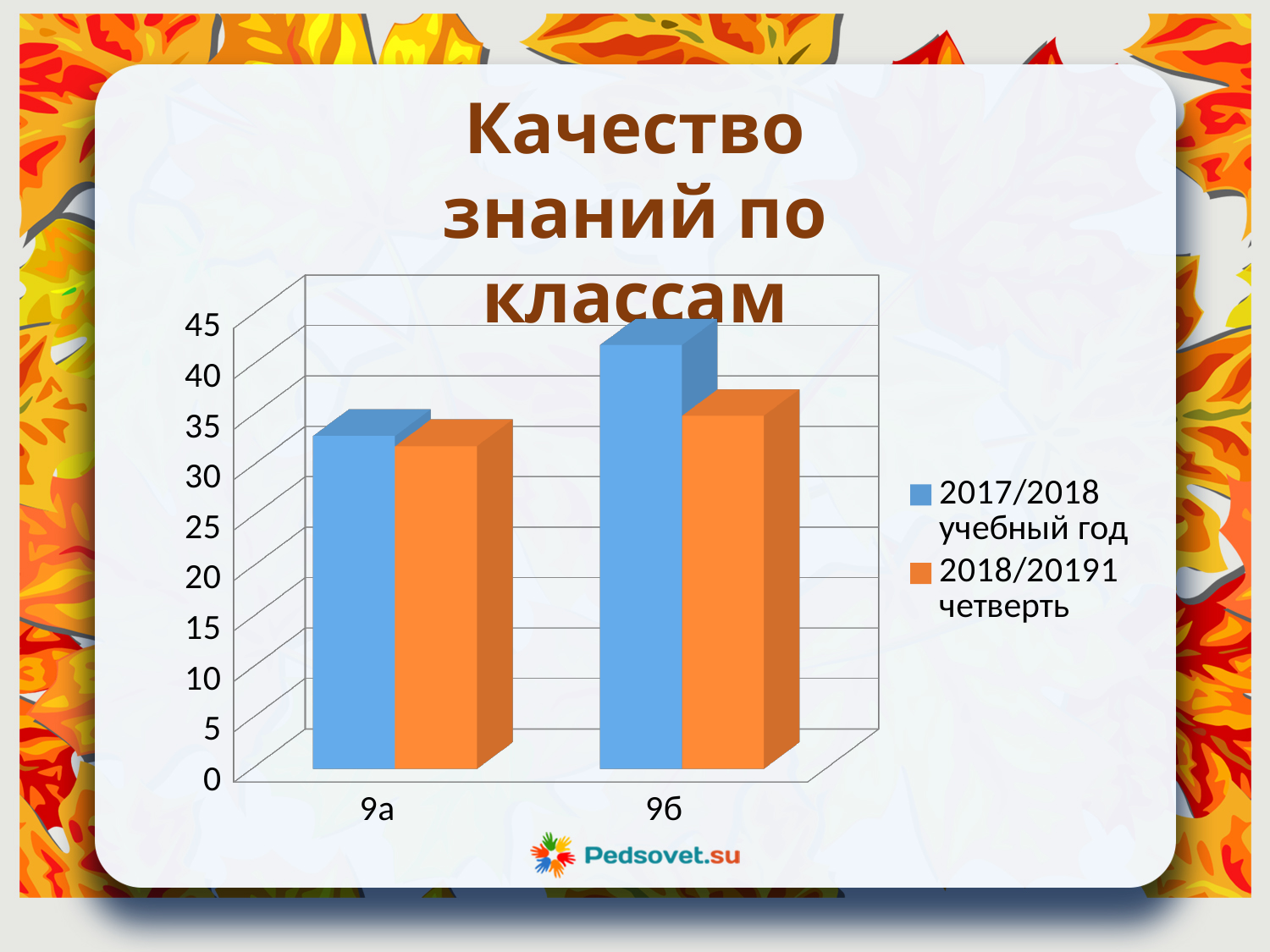
Which colour represents the 2018/2019 1 четверть series in the legend? orange Is the value for 9б in the 2018/2019 1 четверть series greater or less than 40? less Is the value for 9а in the 2017/2018 учебный год series greater or less than 30? greater How many series does the legend list? 2 How many classes (categories) are shown on the x axis? 2 Which class has the higher value for the 2018/2019 1 четверть series? 9б Which class has the highest bar for the 2017/2018 учебный год series? 9б Do the values for the 2017/2018 учебный год series rise or fall from 9а to 9б? rise Is the value for 9б in the 2017/2018 учебный год series greater or less than 40? greater What is the title of the chart? Качество знаний по классам What kind of chart is shown on the slide? bar chart For class 9б, which series has the larger value: 2017/2018 учебный год or 2018/2019 1 четверть? 2017/2018 учебный год